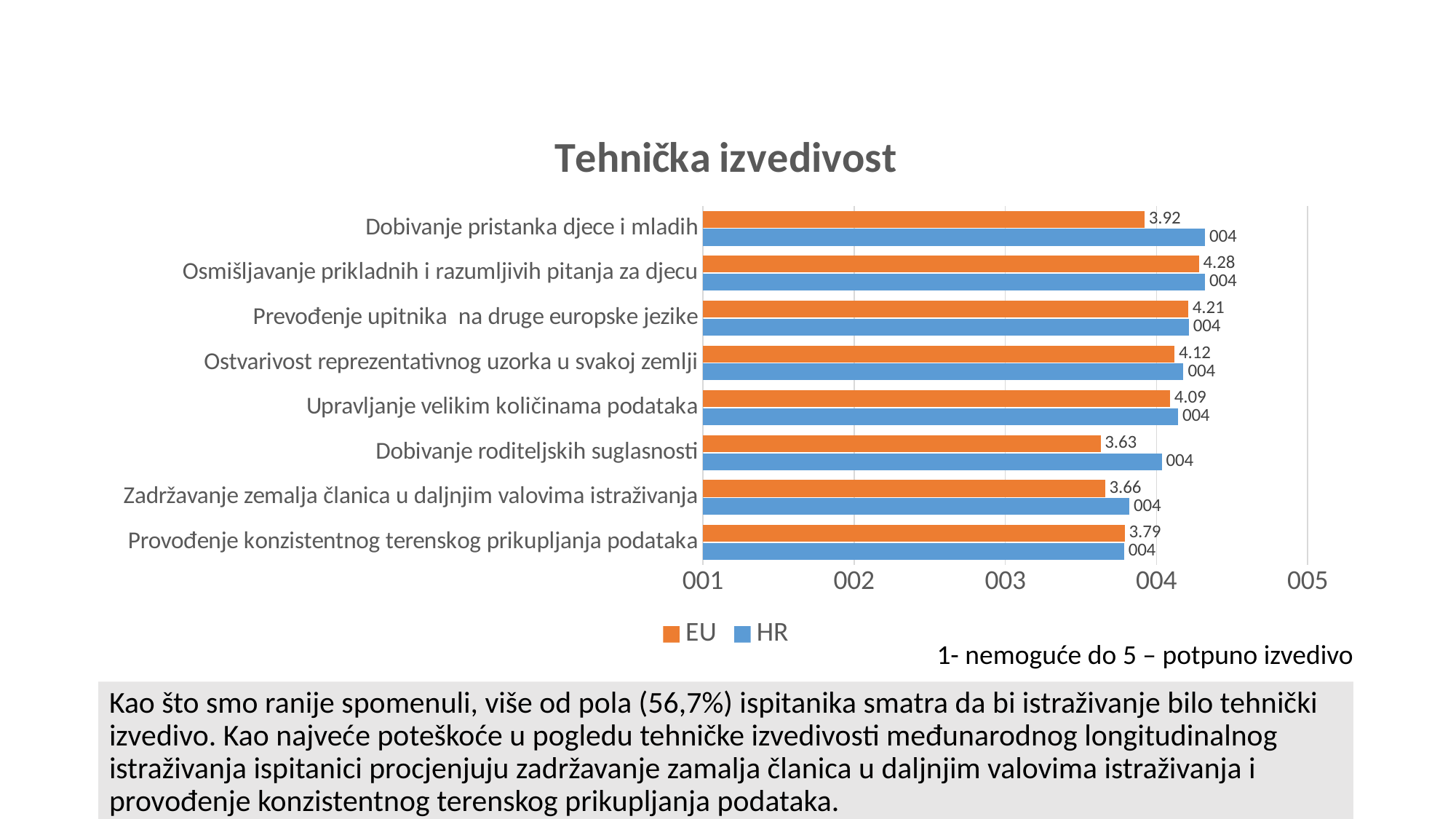
What is the EU value for "Osmišljavanje prikladnih i razumljivih pitanja za djecu"? 4.28 How many series does the legend list? 2 For "Dobivanje pristanka djece i mladih", which series has the larger value, EU or HR? HR What is the EU value for "Dobivanje roditeljskih suglasnosti"? 3.63 What is the difference between the EU values for "Prevođenje upitnika na druge europske jezike" and "Dobivanje pristanka djece i mladih"? 0.29 Is the HR value for "Dobivanje pristanka djece i mladih" greater or less than 004? greater How many categories are shown in the chart? 8 Which category has the highest EU value? Osmišljavanje prikladnih i razumljivih pitanja za djecu What type of chart is shown on the slide? Bar chart What is the EU value for "Provođenje konzistentnog terenskog prikupljanja podataka"? 3.79 Which category has the lowest EU value? Dobivanje roditeljskih suglasnosti Is the HR value for "Zadržavanje zemalja članica u daljnjim valovima istraživanja" greater or less than 004? less